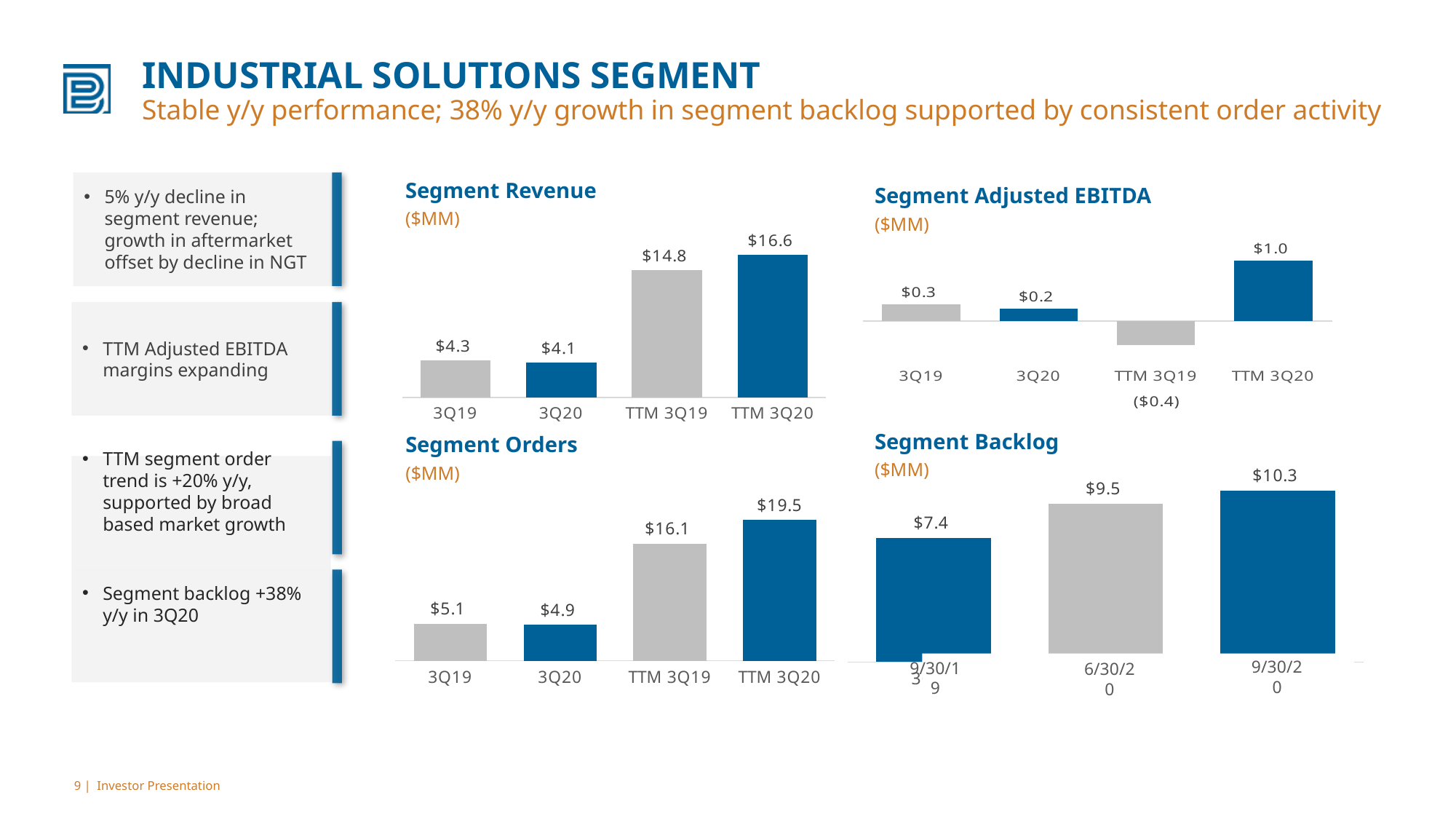
In the Segment Adjusted EBITDA chart, what is the value for TTM 3Q19? ($0.4) In the Segment Backlog chart, what is the value for 6/30/20? $9.5 In the Segment Backlog chart, do the values rise or fall from left to right? Rise In the Segment Orders chart, what is the difference between TTM 3Q20 and TTM 3Q19? $3.4 In the Segment Orders chart, which is larger, 3Q19 or 3Q20? 3Q19 In the Segment Revenue chart, what is the value for 3Q19? $4.3 What unit is shown under the Segment Revenue chart title? ($MM) In the Segment Adjusted EBITDA chart, which category has the highest value? TTM 3Q20 In the Segment Revenue chart, what is the value for TTM 3Q20? $16.6 How many bars are in the Segment Backlog chart? 3 What kind of chart is the Segment Orders chart? Bar chart In the Segment Backlog chart, which date has the lowest value? 9/30/19